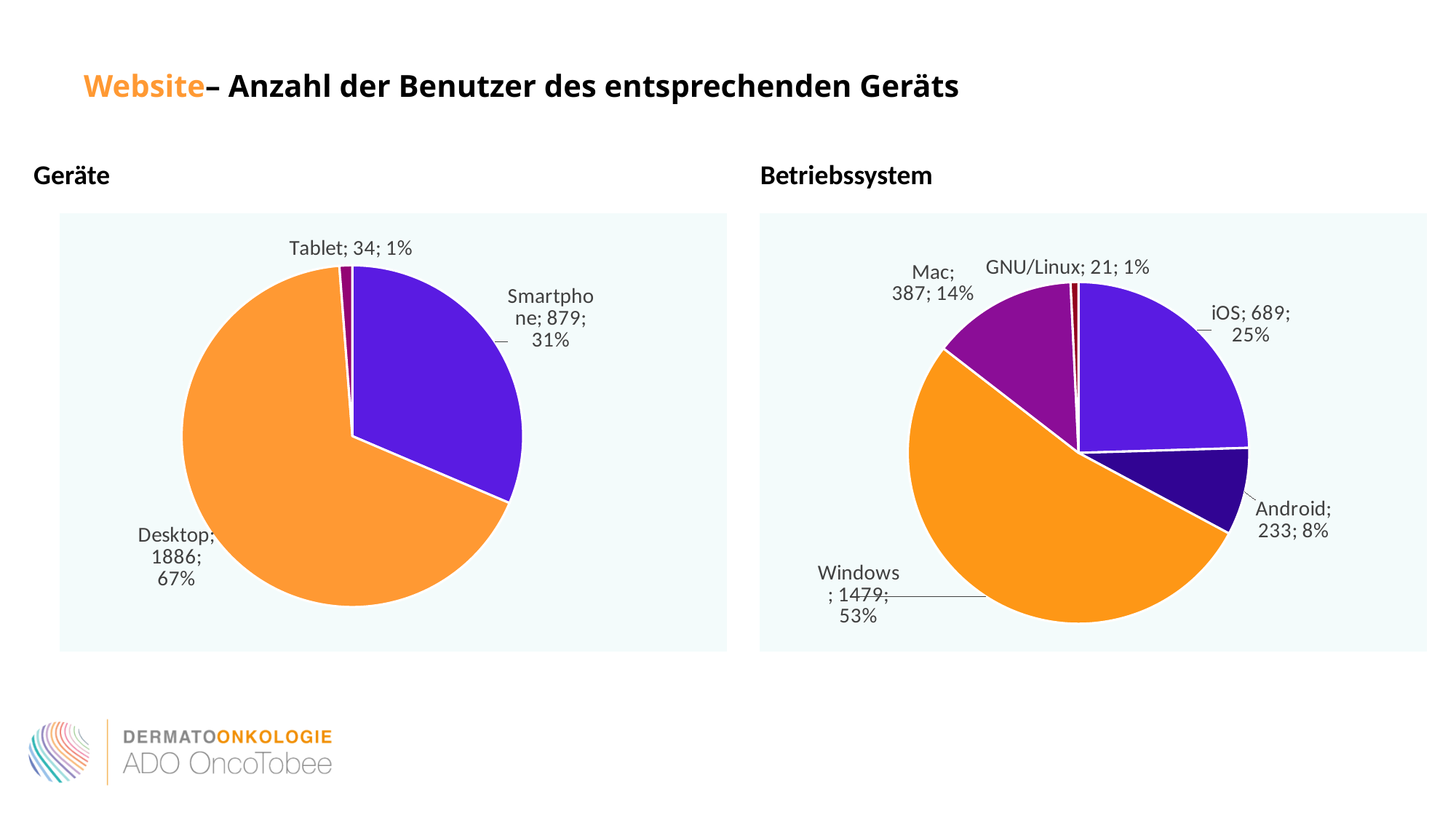
In the Betriebssystem chart, which operating system has the most users? Windows In the Geräte chart, which device has the fewest users? Tablet In the Betriebssystem chart, which has more users, iOS or Android? iOS What type of chart is the Geräte chart? Pie chart In the Geräte chart, how many users are shown for Desktop? 1886 In the Betriebssystem chart, what is the difference in users between iOS and Mac? 302 In the Betriebssystem chart, how many users are shown for Mac? 387 In the Betriebssystem chart, how many categories are shown? 5 In the Geräte chart, what is the difference in users between Desktop and Smartphone? 1007 In the Geräte chart, how many categories are shown? 3 In the Geräte chart, what share of the pie does Smartphone have? 31% In the Betriebssystem chart, what share of the pie does Android have? 8%